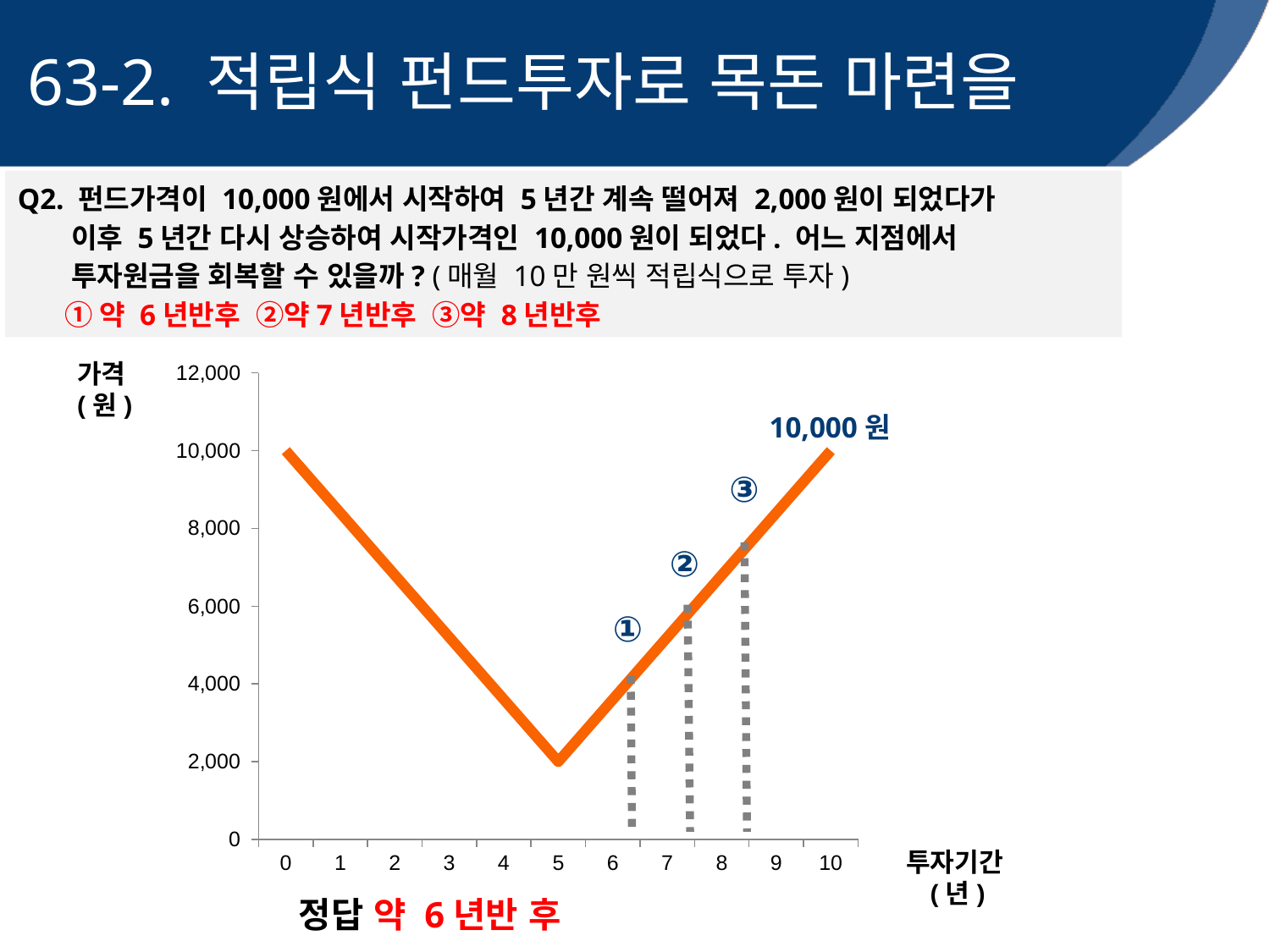
What is the fund price at year 5, the lowest point of the line? 2,000 What is the label of the x axis of the chart? 투자기간 (년) Does the fund price rise or fall between year 5 and year 10? Rise Which is larger, the fund price at year 4 or at year 7? Year 7 At which year on the x axis does the fund price reach its lowest value? 5 What kind of chart is shown on the slide? Line chart Is the fund price at year 7 greater or less than 4,000? greater What is the fund price at year 10 according to the data label on the chart? 10,000 원 Does the fund price rise or fall between year 0 and year 5? Fall What is the difference between the starting price at year 0 and the lowest price at year 5? 8,000 What is the fund price at year 0 on the chart? 10,000 Is the fund price at year 3 greater or less than 6,000? less